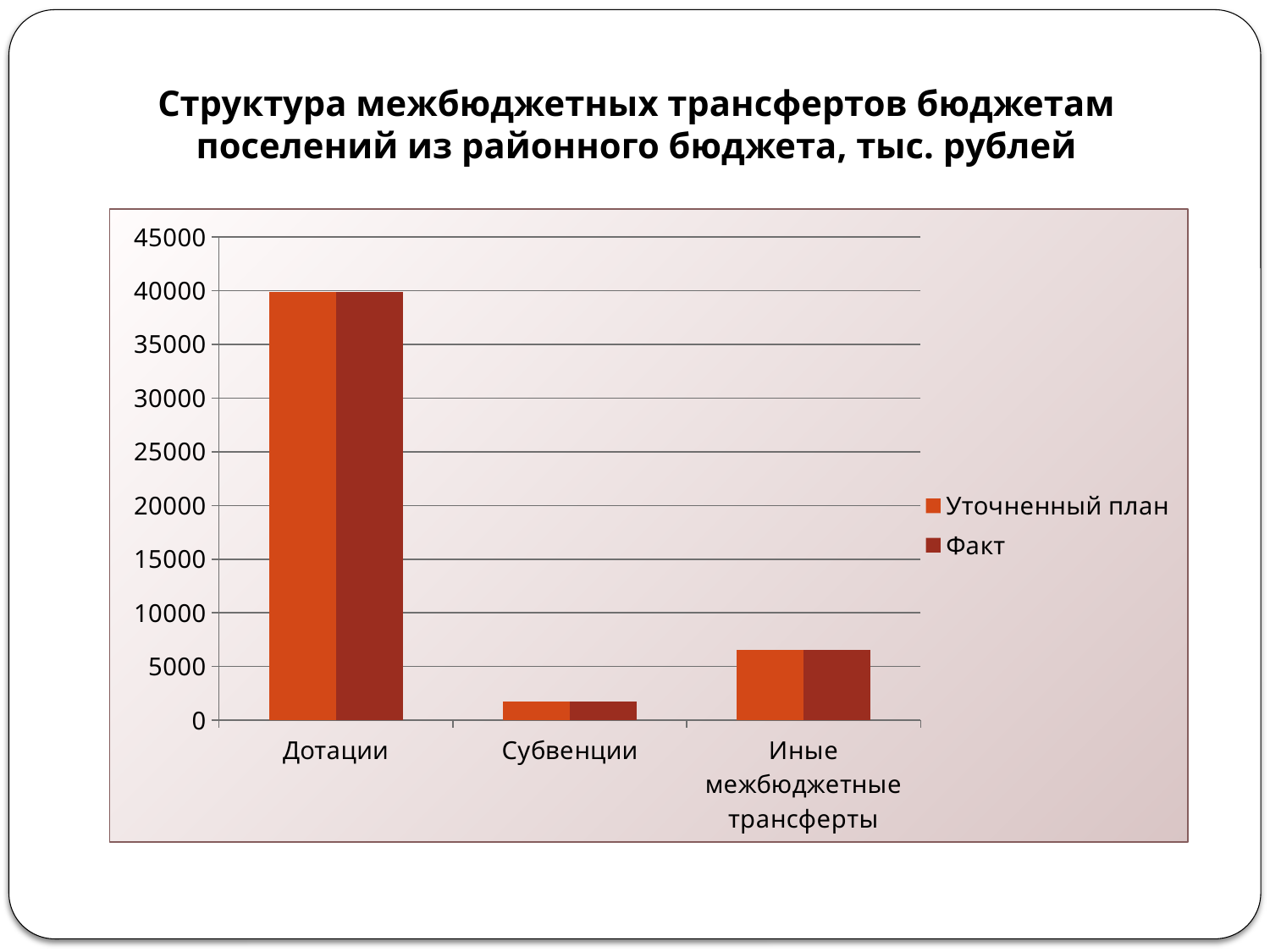
What is the title of the chart? Структура межбюджетных трансфертов бюджетам поселений из районного бюджета, тыс. рублей How many series does the legend list? 2 How many categories are shown on the x axis of the chart? 3 Which is larger for Факт: Субвенции or Иные межбюджетные трансферты? Иные межбюджетные трансферты Is the value for Иные межбюджетные трансферты (Факт) greater or less than 10000? less Is the value for Иные межбюджетные трансферты (Уточненный план) greater or less than 5000? greater Which category has the highest value for Уточненный план? Дотации Which category has the lowest value for Факт? Субвенции What kind of chart is shown on the slide? bar chart Is the value for Субвенции (Факт) greater or less than 5000? less What are the two series named in the legend? Уточненный план and Факт